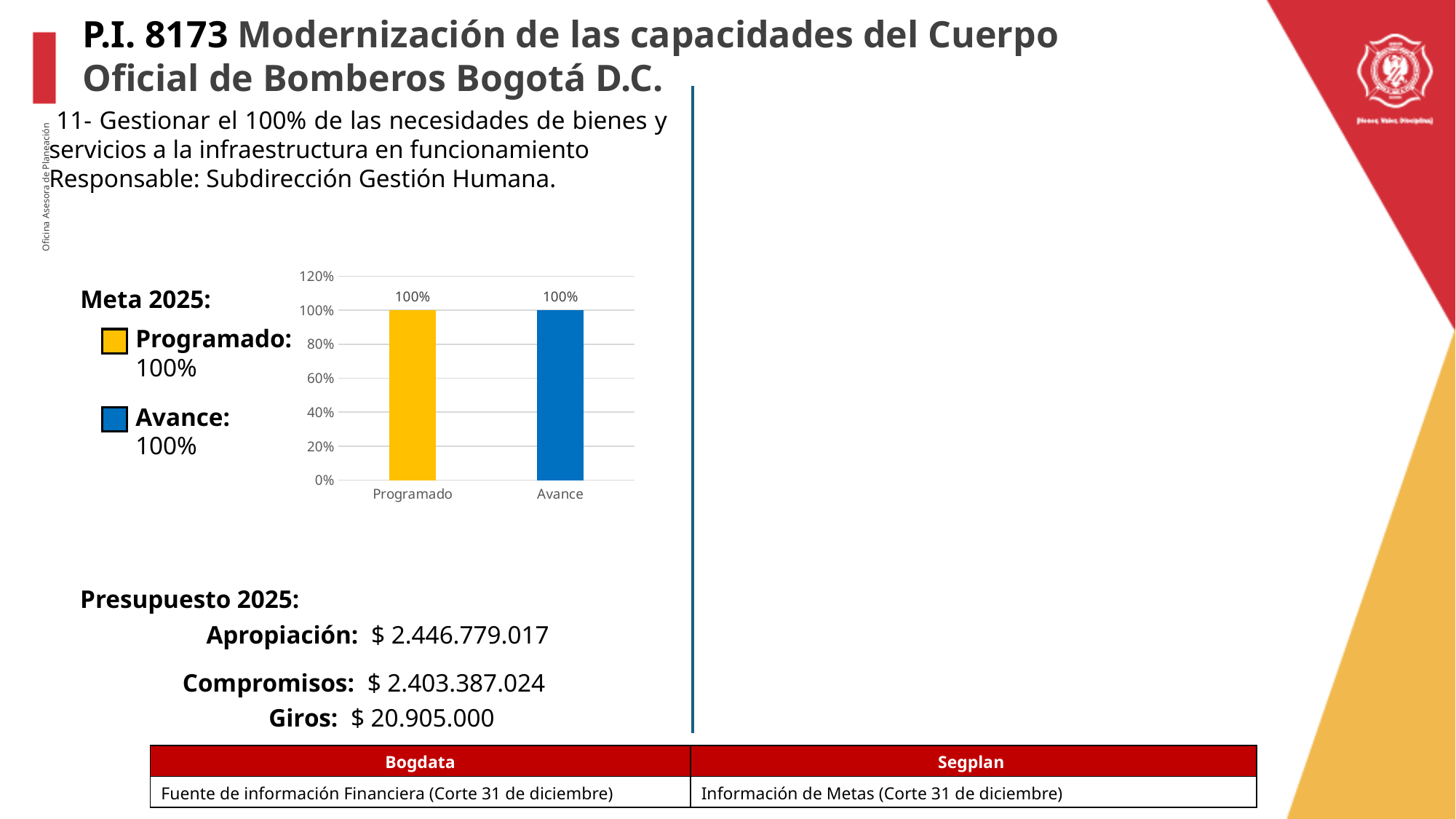
What is the difference between the Programado and Avance values? 0% What is the value of the Avance bar? 100% Are the Programado and Avance values equal? yes What kind of chart is shown on the slide? bar chart How many bars are plotted in the chart? 2 What is the value of the Programado bar? 100% Is the value for Programado greater or less than 120%? less What colour is the Programado bar? yellow Is the value for Avance greater or less than 80%? greater What is the highest value shown on the vertical axis? 120%